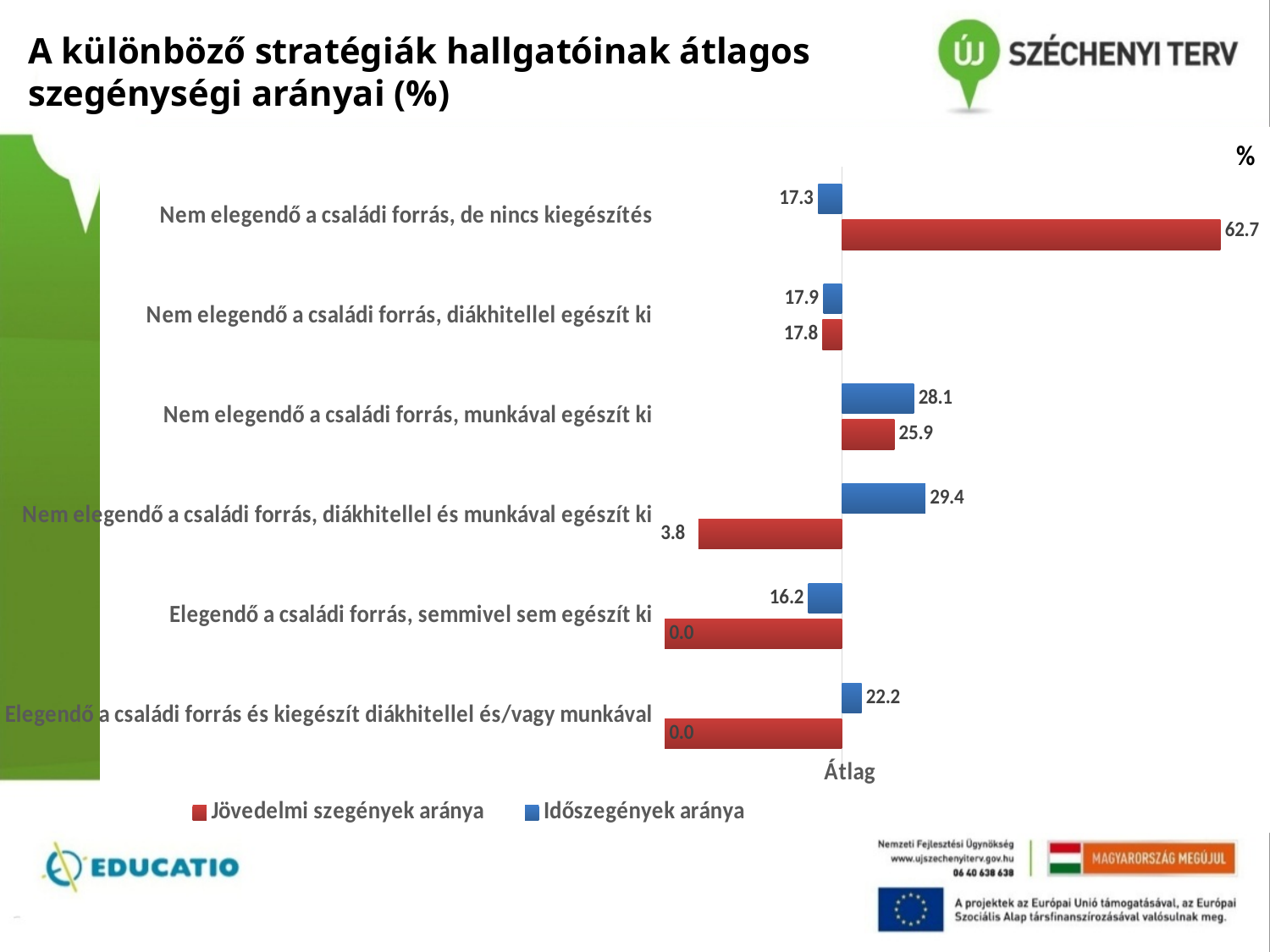
What is the Jövedelmi szegények aránya value for 'Nem elegendő a családi forrás, de nincs kiegészítés'? 62.7 What is the difference between the Időszegények aránya values for 'Nem elegendő a családi forrás, diákhitellel és munkával egészít ki' and 'Nem elegendő a családi forrás, munkával egészít ki'? 1.3 What kind of chart is shown on the slide? Bar chart Which category has the lowest Időszegények aránya value? Elegendő a családi forrás, semmivel sem egészít ki Which category has the highest Jövedelmi szegények aránya value? Nem elegendő a családi forrás, de nincs kiegészítés For 'Nem elegendő a családi forrás, munkával egészít ki', which series has the larger value, Jövedelmi szegények aránya or Időszegények aránya? Időszegények aránya What is the Időszegények aránya value for 'Nem elegendő a családi forrás, diákhitellel és munkával egészít ki'? 29.4 How many series does the legend list? 2 How many categories are shown in the chart? 6 Which category has the highest Időszegények aránya value? Nem elegendő a családi forrás, diákhitellel és munkával egészít ki What is the Jövedelmi szegények aránya value for 'Nem elegendő a családi forrás, munkával egészít ki'? 25.9 What is the Időszegények aránya value for 'Elegendő a családi forrás és kiegészít diákhitellel és/vagy munkával'? 22.2